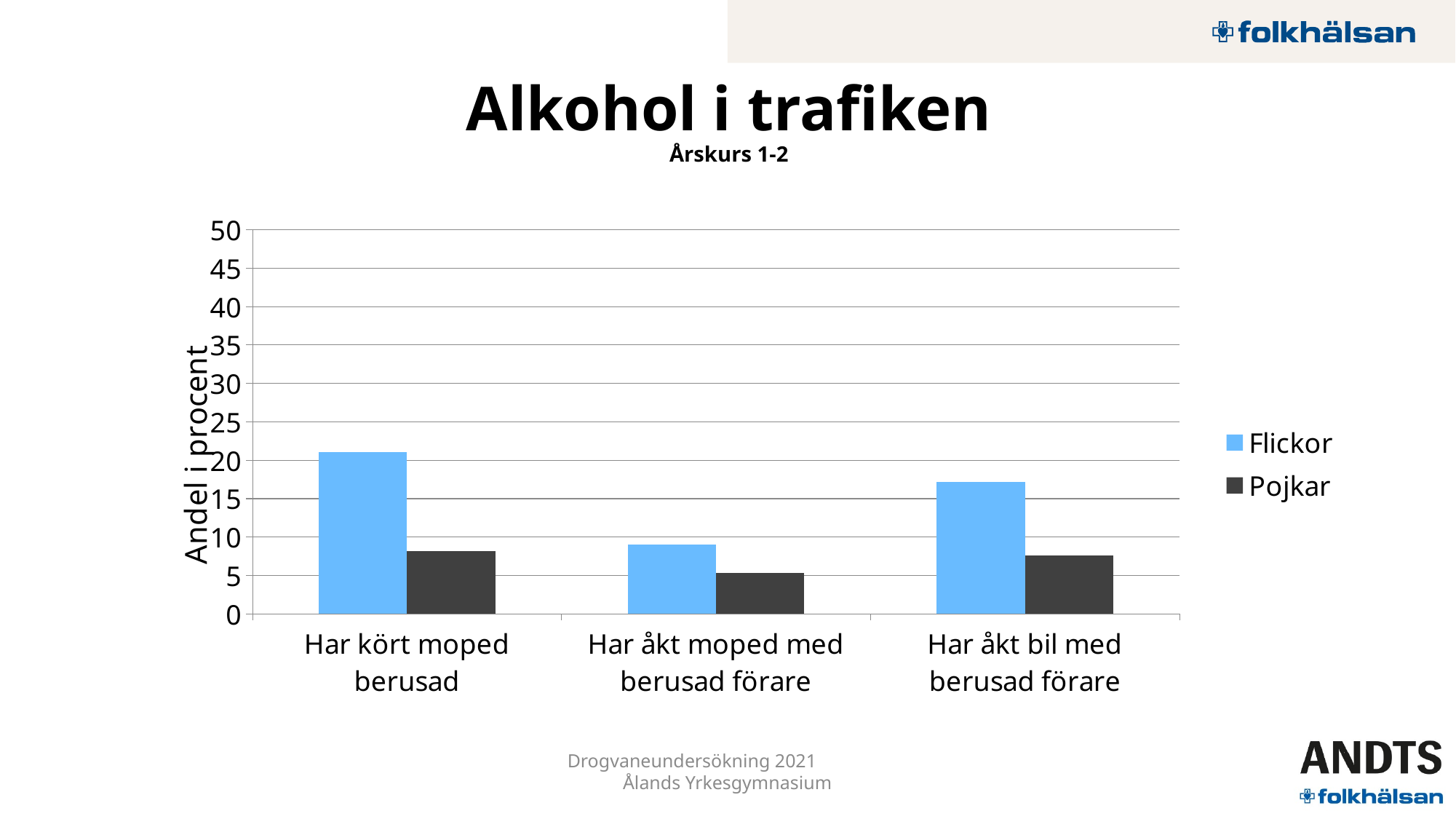
How many categories are shown on the x axis? 3 Is the value for Flickor in 'Har åkt bil med berusad förare' greater or less than 15? greater Is the value for Pojkar in 'Har åkt bil med berusad förare' greater or less than 10? less What is the label of the y axis? Andel i procent What kind of chart is shown on the slide? bar chart For 'Har kört moped berusad', which series has the larger value, Flickor or Pojkar? Flickor Which category has the lowest value for Pojkar? Har åkt moped med berusad förare Is the value for Flickor in 'Har kört moped berusad' greater or less than 15? greater Which category has the highest value for Flickor? Har kört moped berusad How many series does the legend list? 2 Which category has the lowest value for Flickor? Har åkt moped med berusad förare